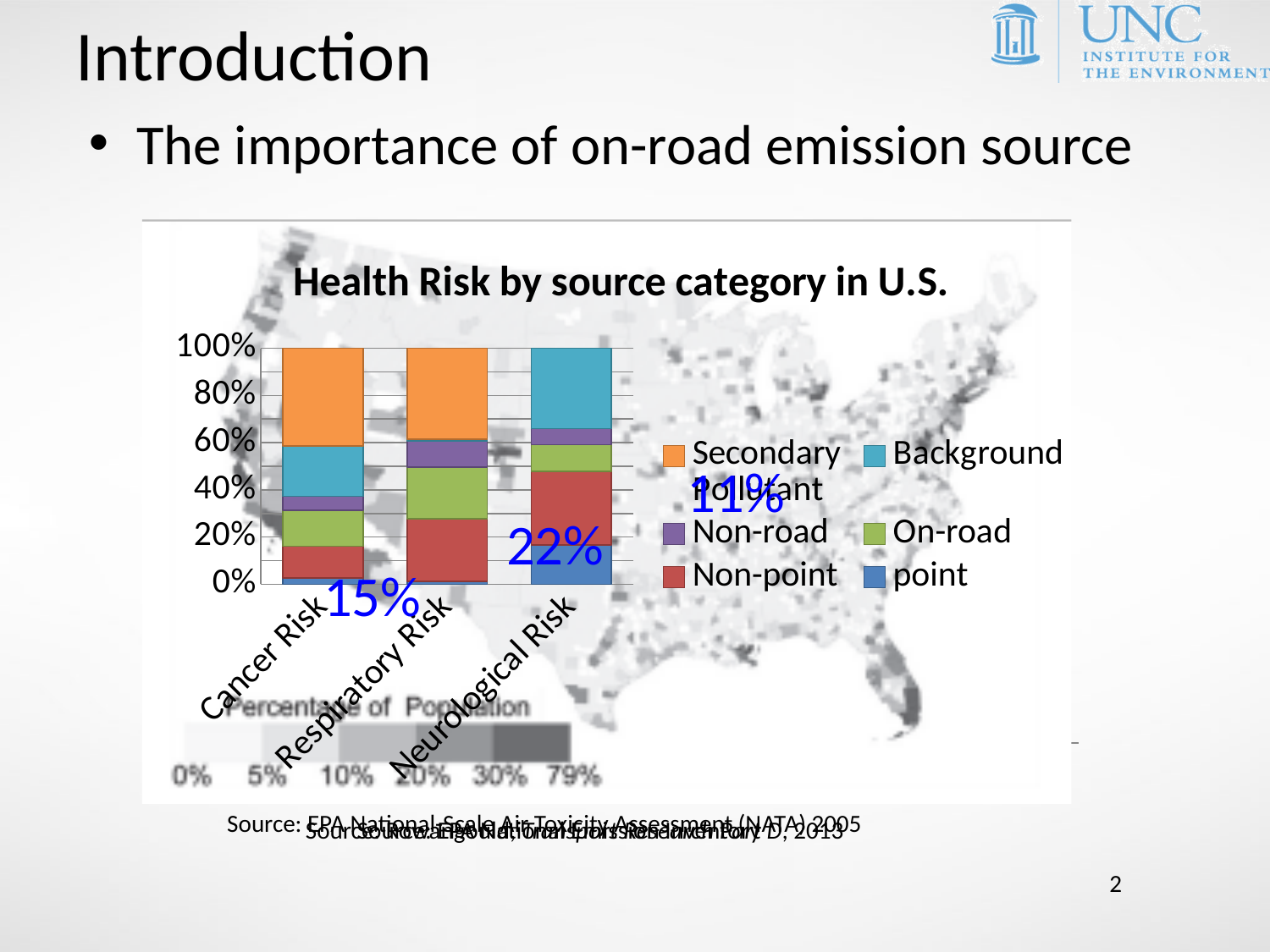
What does each stacked bar in the chart total? 100% How many risk categories are plotted along the x axis of the chart? 3 Is the point segment for Cancer Risk greater or less than 10%? less What is the title of the chart? Health Risk by source category in U.S. Which has the larger Non-point segment, Cancer Risk or Neurological Risk? Neurological Risk Which colour represents the On-road series in the chart? Green Is the point segment for Neurological Risk greater or less than 20%? less Which has the larger point segment, Cancer Risk or Neurological Risk? Neurological Risk Which has the larger Secondary segment, Cancer Risk or Neurological Risk? Cancer Risk How many series does the chart's legend list? 6 Is the Background pollutant segment for Neurological Risk greater or less than 20%? greater What kind of chart is shown on the slide? Stacked bar chart